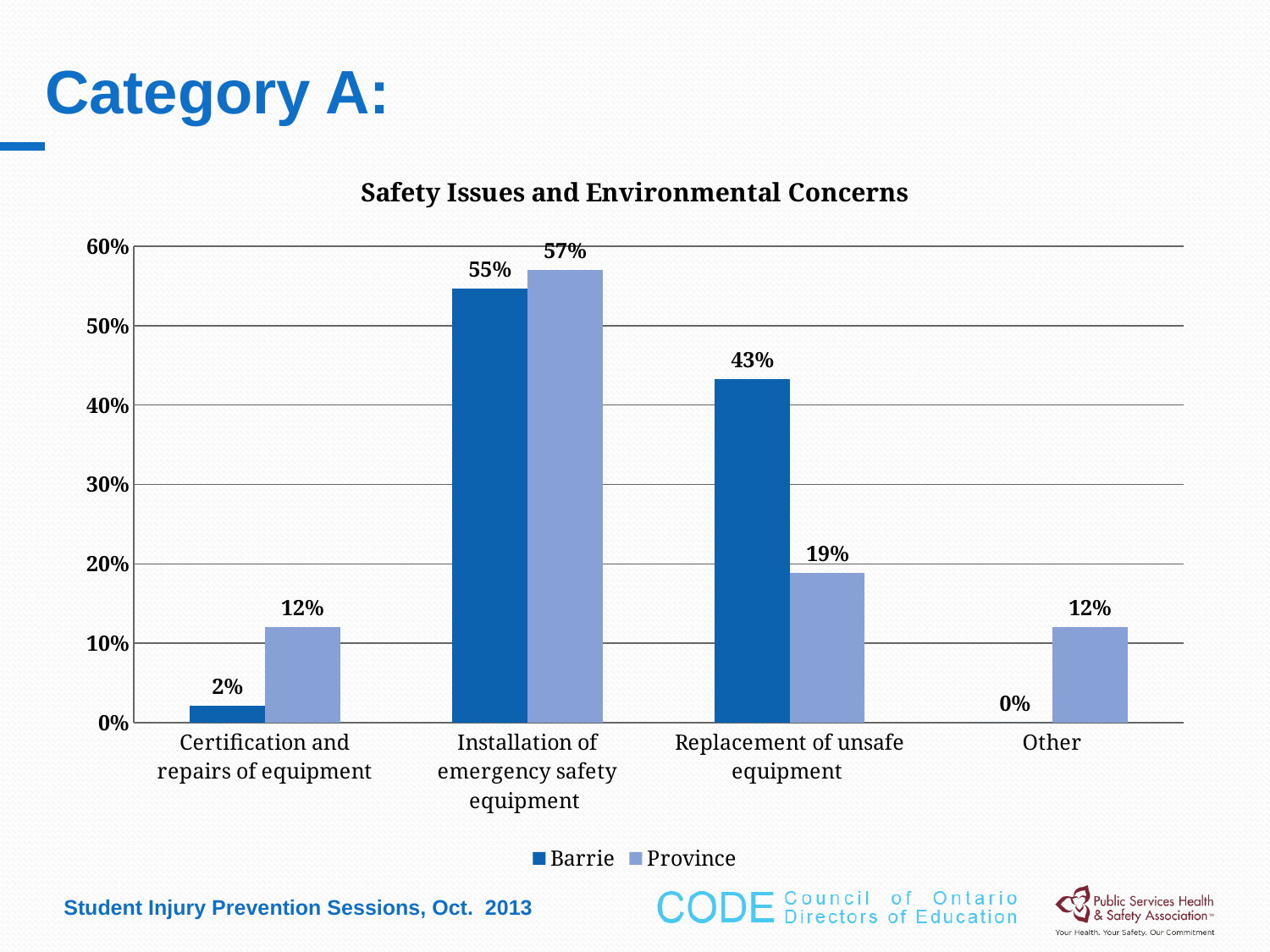
What is the Barrie value for Certification and repairs of equipment? 2% Which category has the highest Province value? Installation of emergency safety equipment What kind of chart is shown on the slide? Bar chart For Certification and repairs of equipment, which series has the larger value, Barrie or Province? Province What is the difference between the Barrie and Province values for Replacement of unsafe equipment? 24% What is the Province value for Other? 12% How many categories are shown on the x axis? 4 Which category has the lowest Barrie value? Other What is the Barrie value for Installation of emergency safety equipment? 55% What is the Province value for Replacement of unsafe equipment? 19% How many series does the legend list? 2 What is the title of the chart? Safety Issues and Environmental Concerns